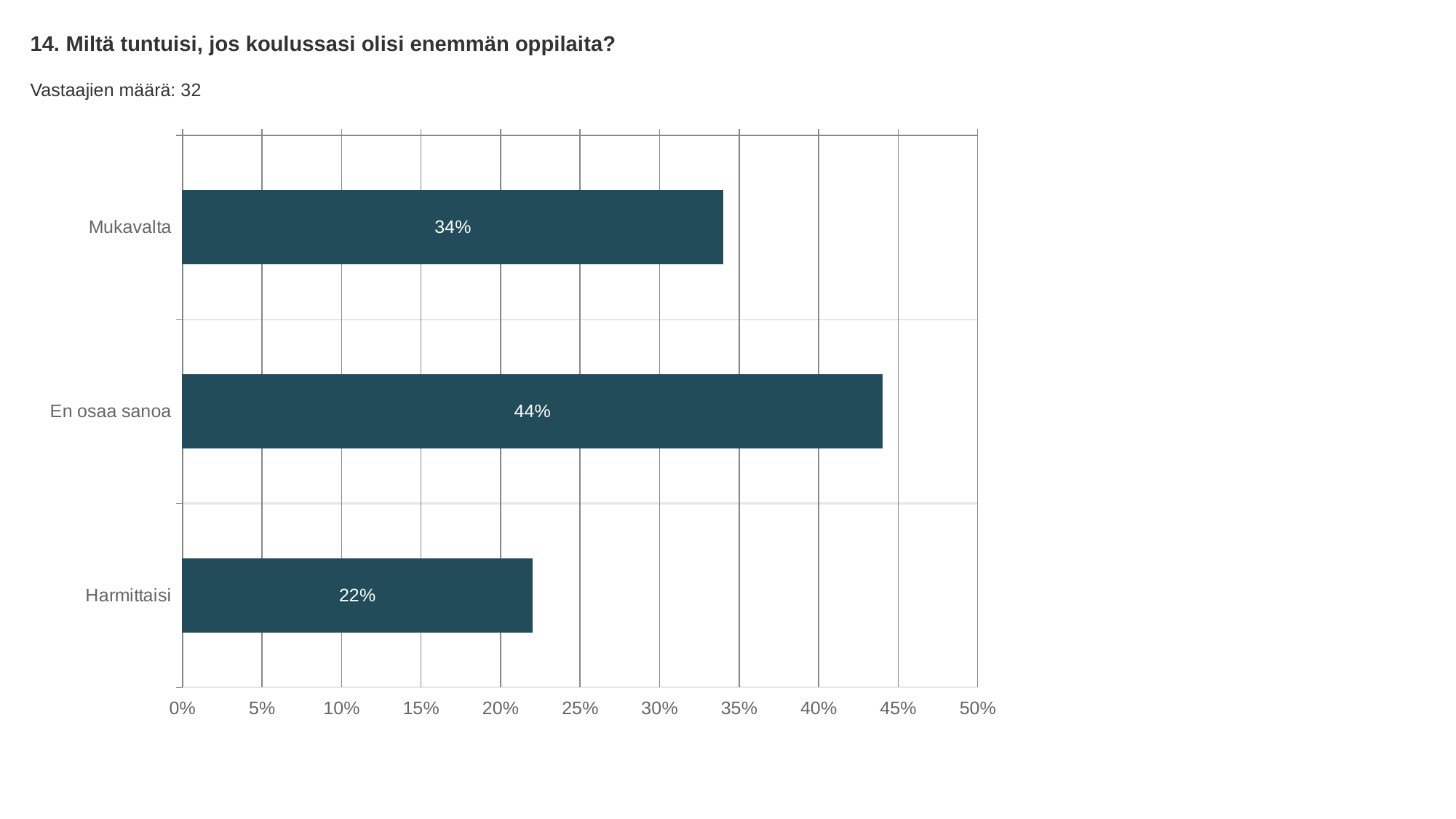
Which category has the lowest value? Harmittaisi What kind of chart is shown on the slide? Bar chart Is the value for En osaa sanoa greater or less than 40%? greater What is the difference between the values for Mukavalta and Harmittaisi? 12% What is the difference between the values for En osaa sanoa and Mukavalta? 10% How many categories are shown in the chart? 3 What is the value for Harmittaisi? 22% What is the value for Mukavalta? 34% Which is larger, the value for Mukavalta or the value for Harmittaisi? Mukavalta What is the value for En osaa sanoa? 44% Which category has the highest value? En osaa sanoa How many respondents (Vastaajien määrä) does the slide report? 32